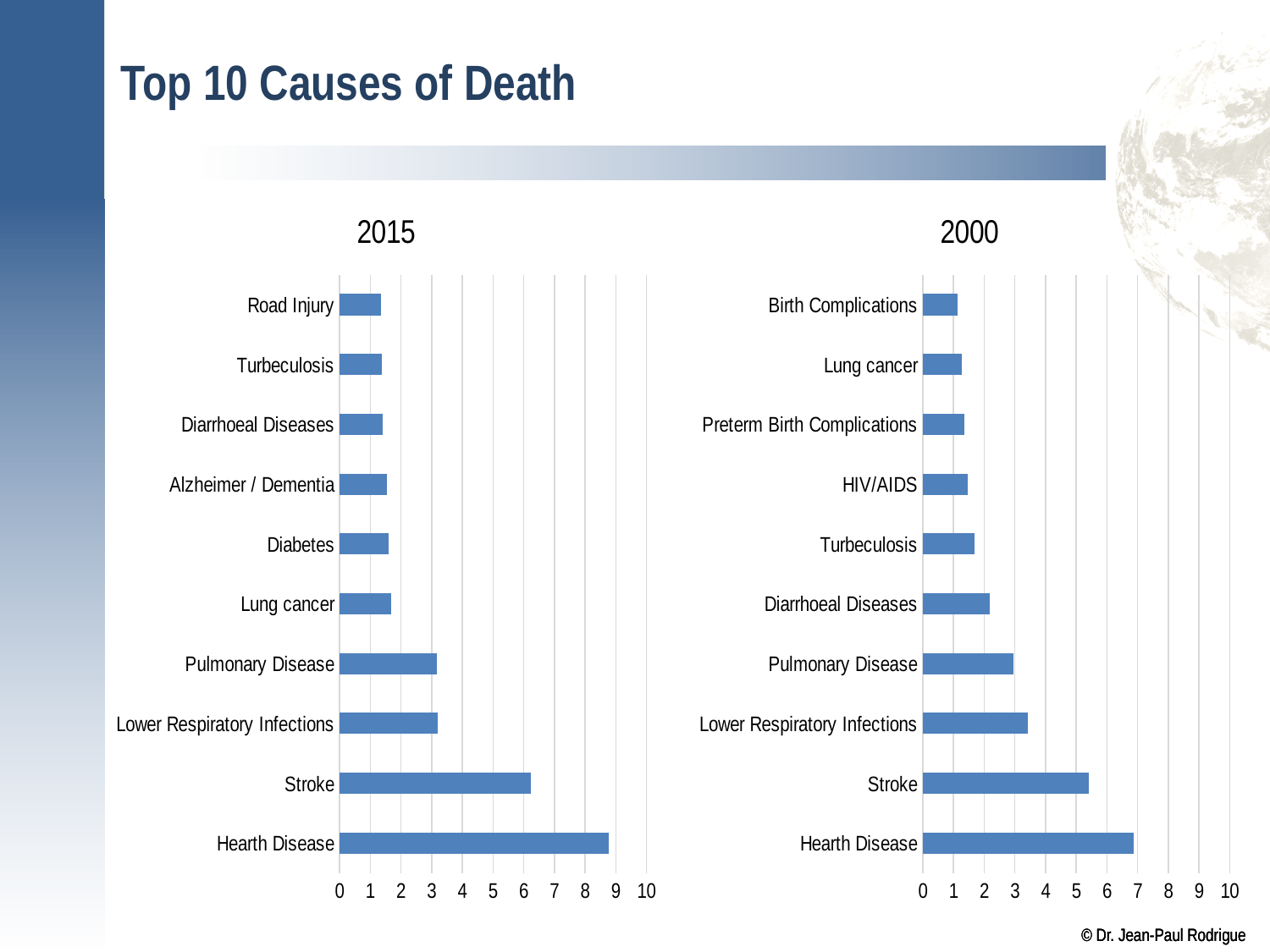
In the 2000 chart, which cause of death has the highest value? Hearth Disease In the 2000 chart, which is larger, Diarrhoeal Diseases or HIV/AIDS? Diarrhoeal Diseases In the 2015 chart, which is larger, Stroke or Pulmonary Disease? Stroke In the 2015 chart, is the value for Stroke greater or less than 7? less In the 2000 chart, is the value for Stroke greater or less than 5? greater What kind of chart is the 2015 chart? bar chart What is the title of the slide containing the two charts? Top 10 Causes of Death In the 2015 chart, which cause of death has the highest value? Hearth Disease In the 2000 chart, which cause of death has the lowest value? Birth Complications In the 2015 chart, is the value for Hearth Disease greater or less than 8? greater How many causes of death are listed in the 2015 chart? 10